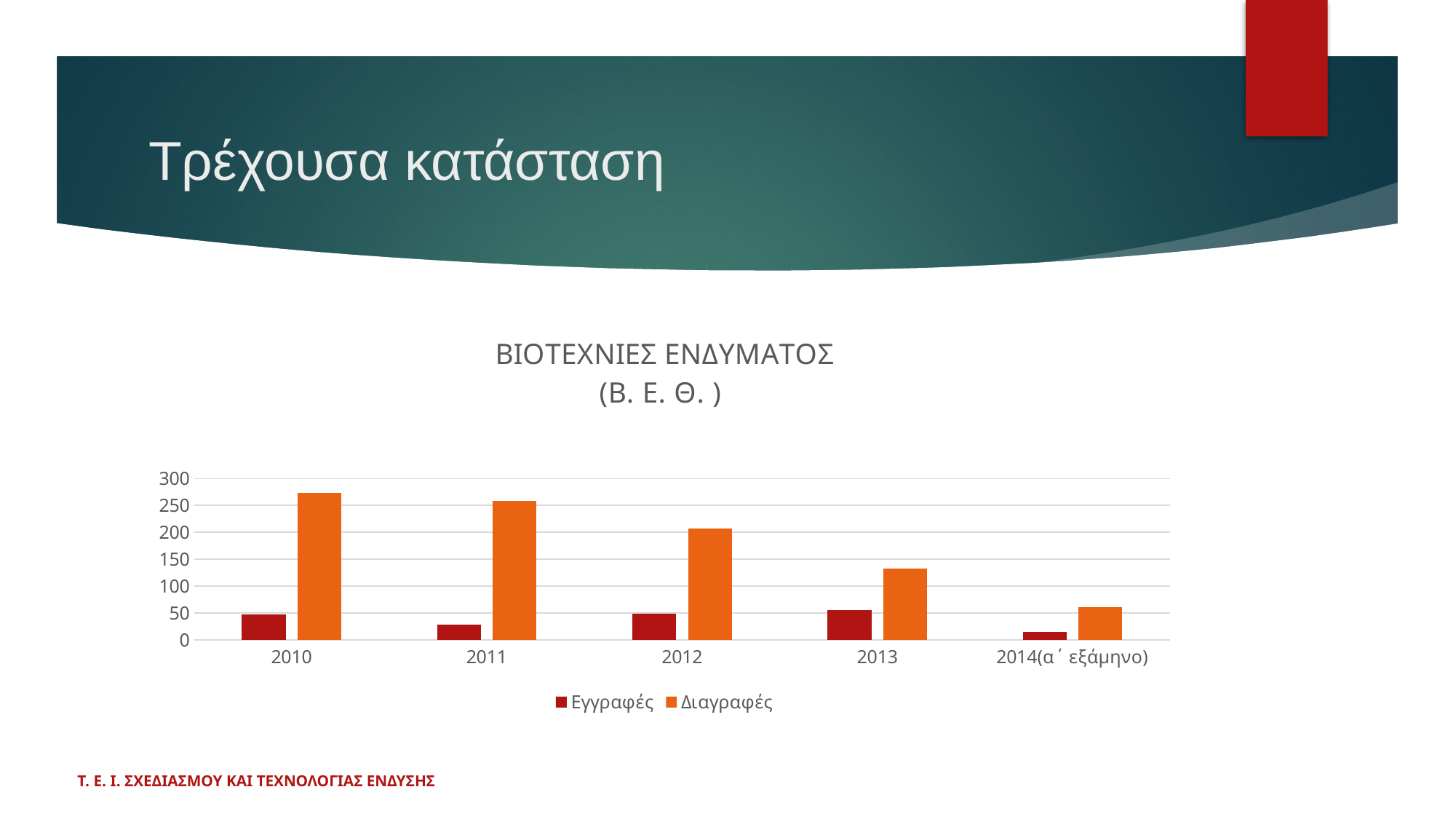
Which category has the lowest value for Εγγραφές? 2014(α΄ εξάμηνο) Is the value for Εγγραφές in 2011 greater or less than 50? less What kind of chart is shown on the slide? Bar chart In 2012, which is larger: Εγγραφές or Διαγραφές? Διαγραφές Which category has the lowest value for Διαγραφές? 2014(α΄ εξάμηνο) How many categories are shown on the x axis? 5 Is the value for Διαγραφές in 2010 greater or less than 250? greater What is the title of the chart? ΒΙΟΤΕΧΝΙΕΣ ΕΝΔΥΜΑΤΟΣ (Β. Ε. Θ. ) Is the value for Διαγραφές in 2013 greater or less than 150? less How many series does the legend list? 2 Do the Διαγραφές values rise or fall from 2010 to 2014(α΄ εξάμηνο)? Fall Which year has the highest value for Διαγραφές? 2010